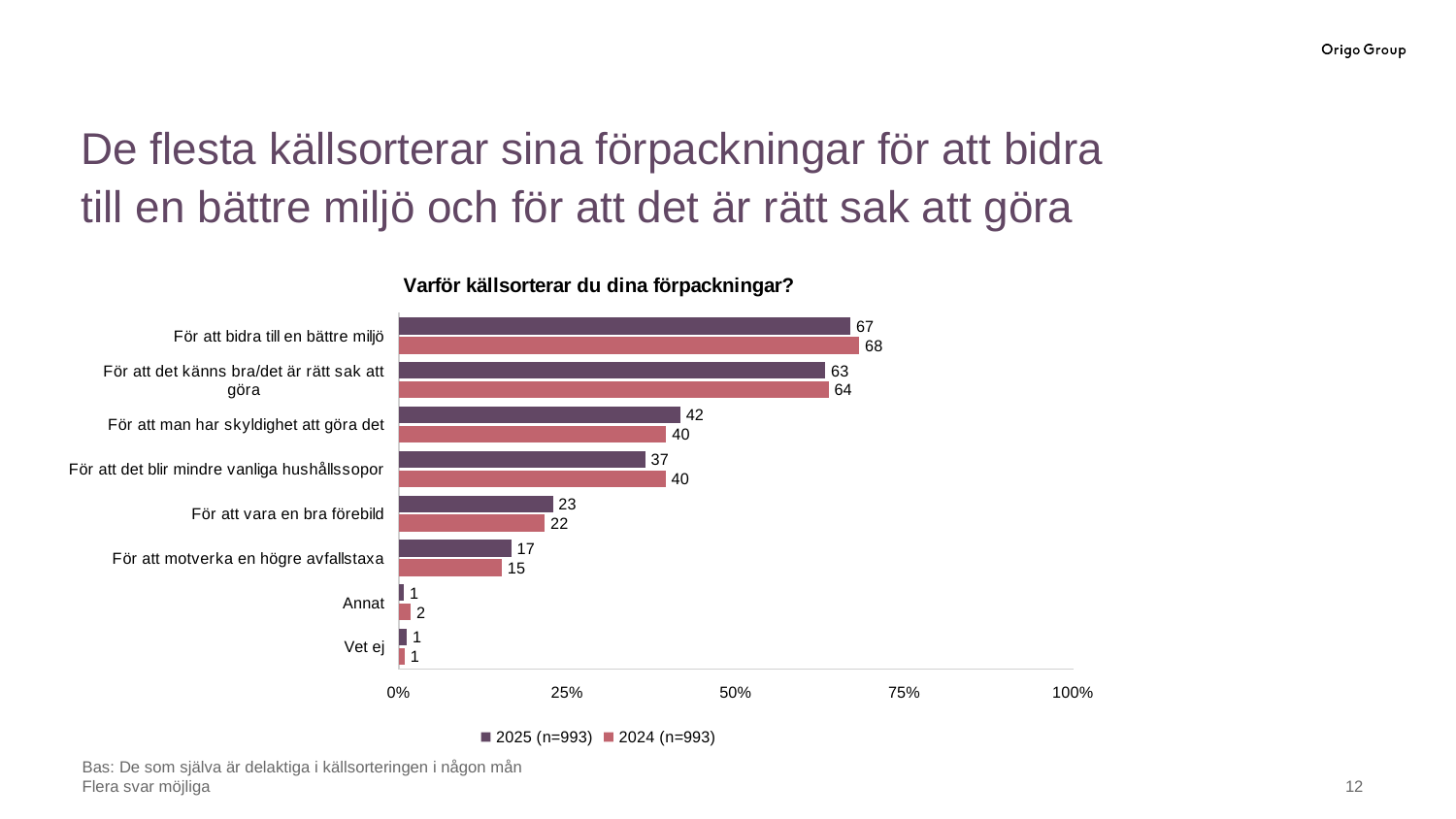
Which category has the highest 2025 (n=993) value? För att bidra till en bättre miljö What is the difference between the 2025 (n=993) and 2024 (n=993) values for "För att det blir mindre vanliga hushållssopor"? 3 What is the 2025 (n=993) value for "För att motverka en högre avfallstaxa"? 17 Which category has the lowest 2024 (n=993) value? Vet ej For "För att man har skyldighet att göra det", which is larger: the 2025 (n=993) value or the 2024 (n=993) value? 2025 (n=993) What is the 2024 (n=993) value for "För att det känns bra/det är rätt sak att göra"? 64 How many categories are shown on the chart? 8 What kind of chart is shown on the slide? bar chart What is the title of the chart? Varför källsorterar du dina förpackningar? How many series does the legend list? 2 Is the 2024 (n=993) value for "För att vara en bra förebild" greater or less than 25%? less What is the 2025 (n=993) value for "För att bidra till en bättre miljö"? 67